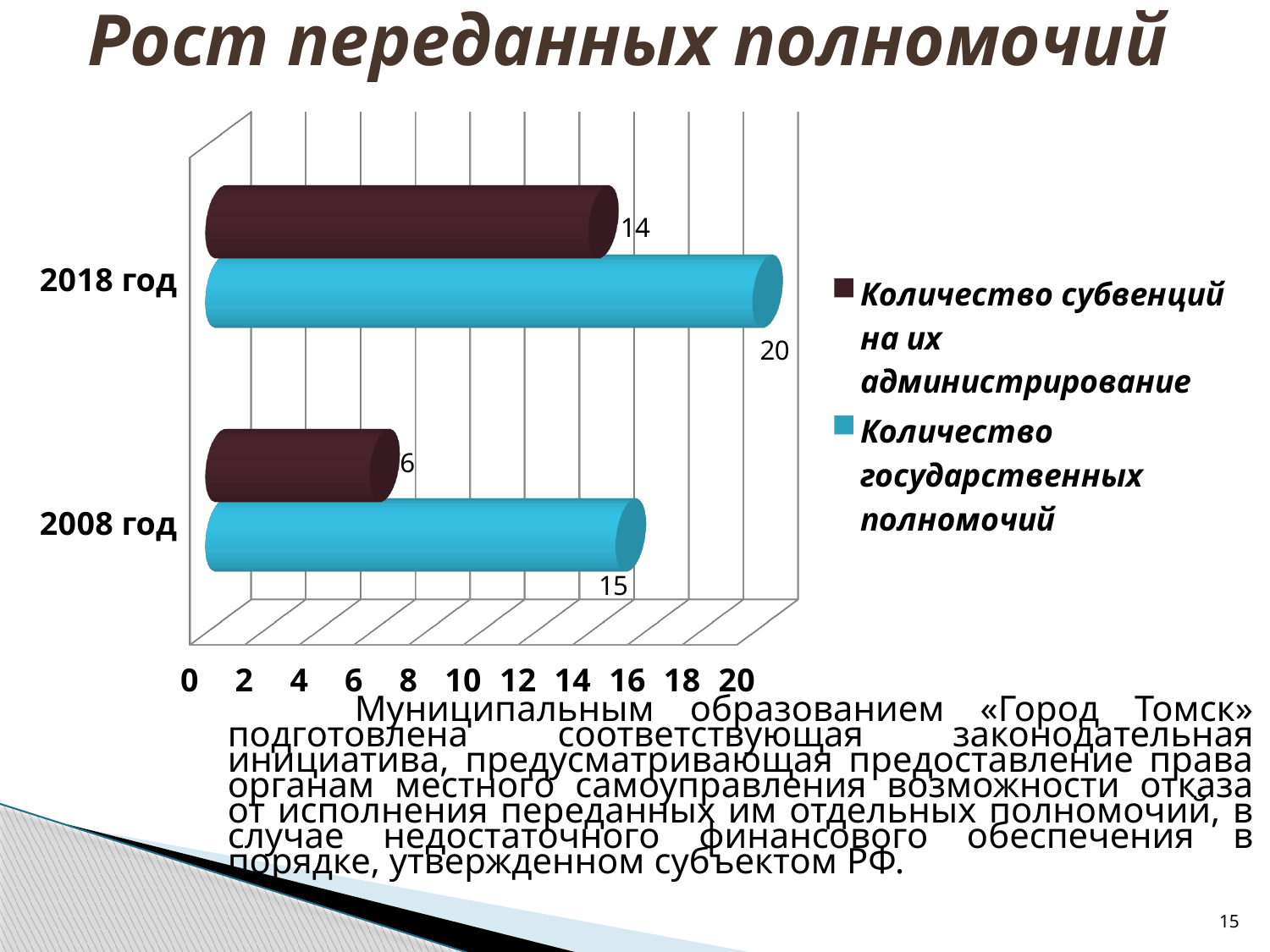
What is the difference between 'Количество государственных полномочий' and 'Количество субвенций на их администрирование' in 2018 год? 6 In 2008 год, which is larger: 'Количество государственных полномочий' or 'Количество субвенций на их администрирование'? Количество государственных полномочий What is the value of 'Количество субвенций на их администрирование' for 2008 год? 6 Which year has the lower value for 'Количество субвенций на их администрирование'? 2008 год How many categories (years) are shown on the chart? 2 By how much did 'Количество субвенций на их администрирование' increase from 2008 год to 2018 год? 8 What is the value of 'Количество государственных полномочий' for 2018 год? 20 What type of chart is shown on the slide? Bar chart Which year has the higher value for 'Количество государственных полномочий'? 2018 год How many series does the legend list? 2 What is the value of 'Количество государственных полномочий' for 2008 год? 15 What is the value of 'Количество субвенций на их администрирование' for 2018 год? 14